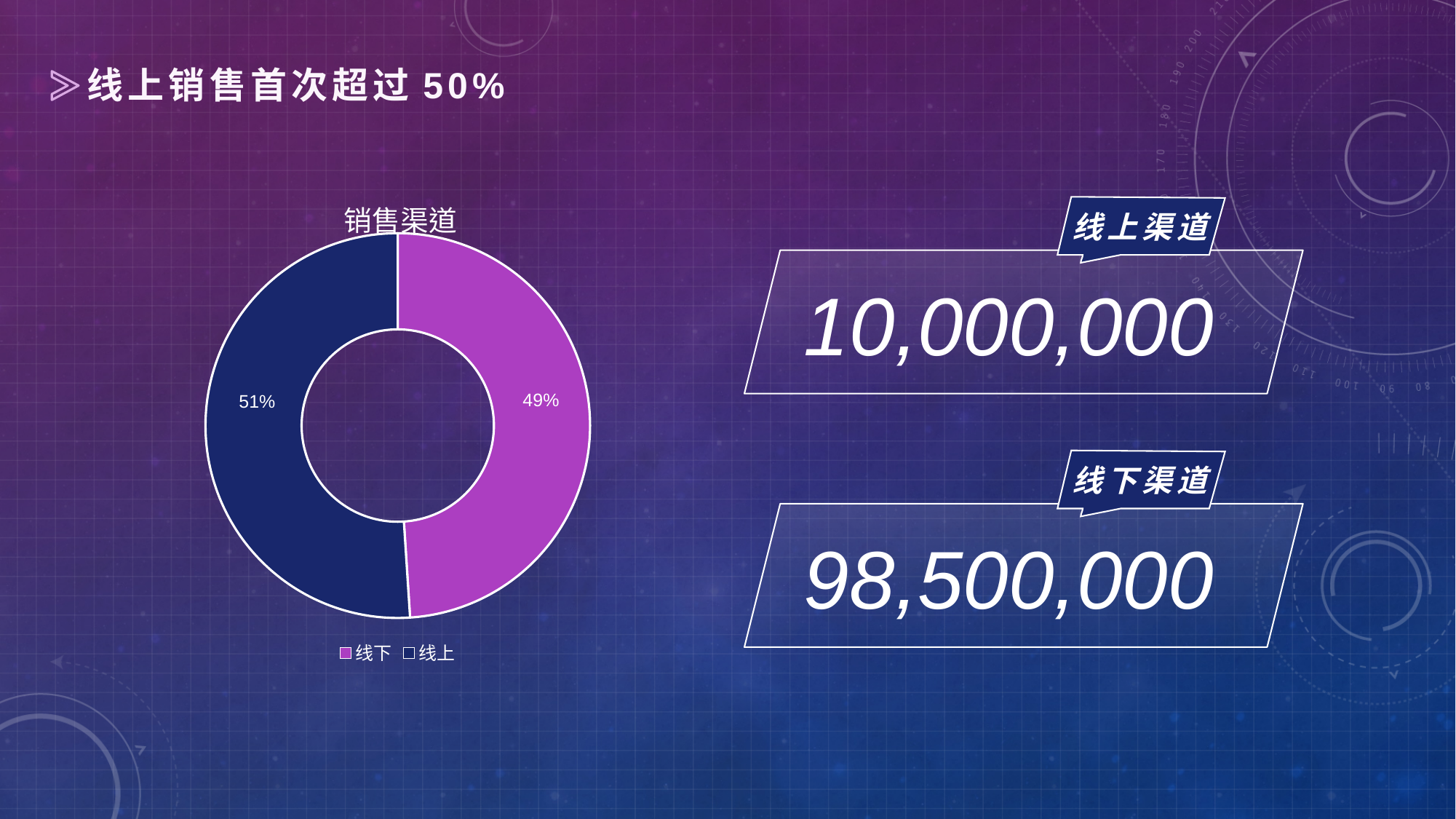
By how many percentage points does 线上 exceed 线下 in the 销售渠道 chart? 2 percentage points What is the value shown for 线下 in the 销售渠道 chart? 49% What share of the 销售渠道 chart does the 线上 slice take? 51% Which colour represents 线下 in the 销售渠道 chart? Purple What is the value shown for 线上 in the 销售渠道 chart? 51% What kind of chart is the 销售渠道 chart? Doughnut (pie) chart What is the title of the chart on the slide? 销售渠道 Is the share for 线下 larger or smaller than the share for 线上? smaller How many categories are shown in the 销售渠道 chart? 2 Is the value for 线上 greater or less than 50%? greater Which category has the larger share in the 销售渠道 chart? 线上 Which category has the smaller share in the 销售渠道 chart? 线下